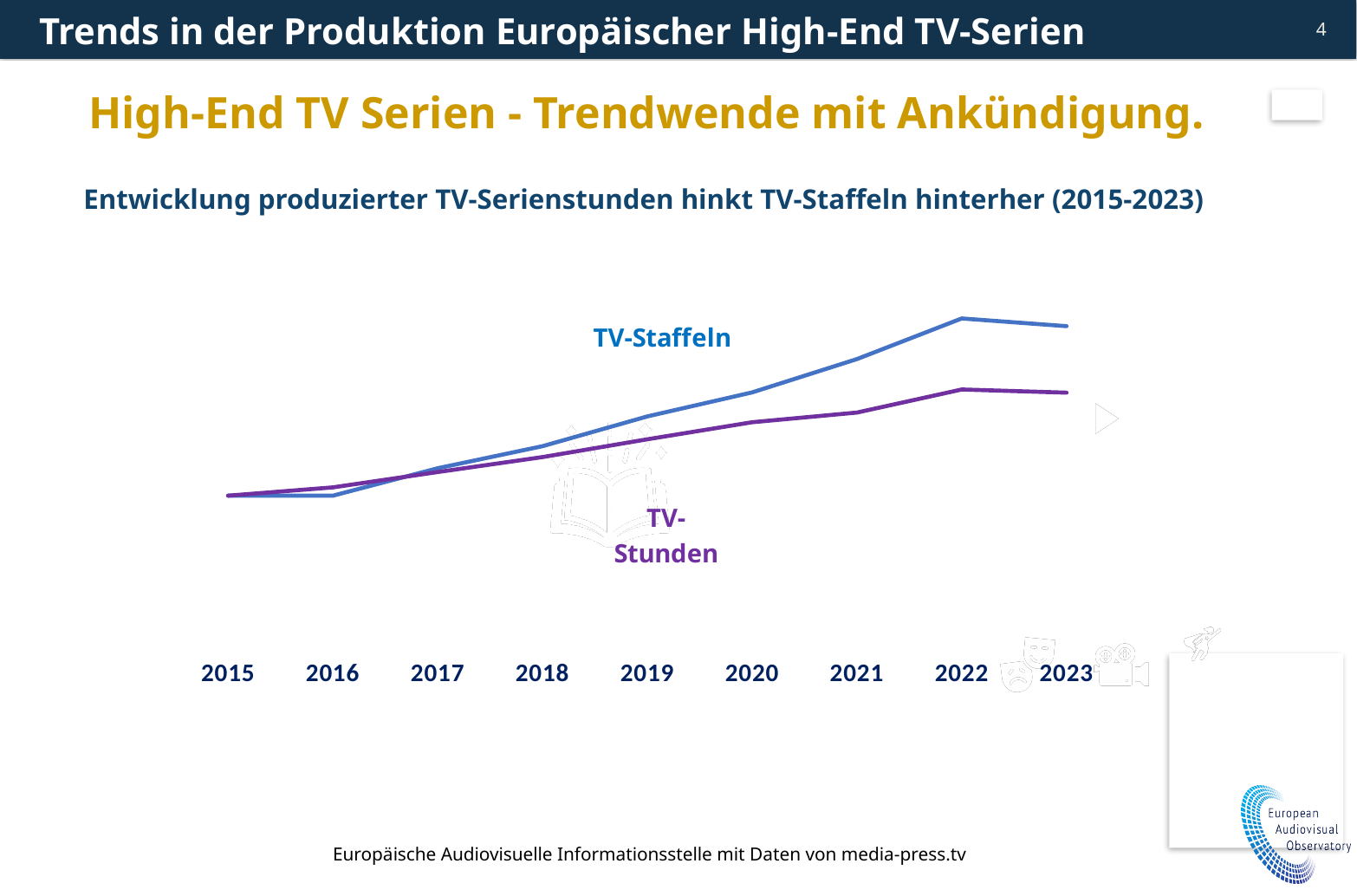
How many series are plotted in the chart? 2 Does the TV-Stunden line rise or fall from 2022 to 2023? fall What is the title of the chart? Entwicklung produzierter TV-Serienstunden hinkt TV-Staffeln hinterher (2015-2023) Which series is higher in 2021, TV-Staffeln or TV-Stunden? TV-Staffeln What kind of chart is shown on the slide? line chart What are the names of the two series plotted in the chart? TV-Staffeln and TV-Stunden How many years are shown on the x axis of the chart? 9 In which year does the TV-Stunden line reach its highest point? 2022 In which year does the TV-Staffeln line reach its highest point? 2022 What is the first year shown on the x axis? 2015 Which series is higher in 2023, TV-Staffeln or TV-Stunden? TV-Staffeln Does the TV-Staffeln line generally rise or fall from 2015 to 2022? rise